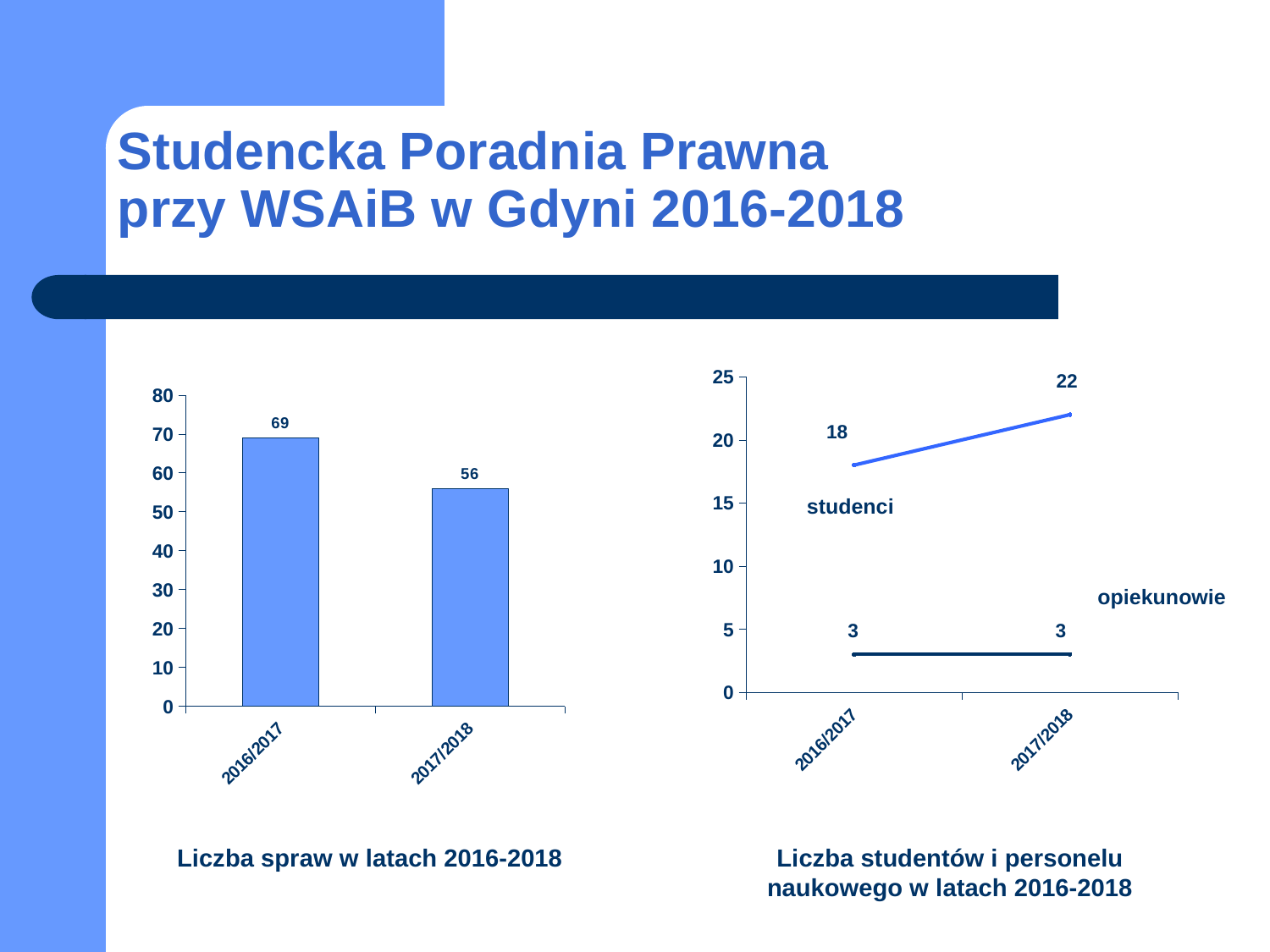
How many series are plotted in the right chart (Liczba studentów i personelu naukowego)? 2 In the left chart (Liczba spraw w latach 2016-2018), what is the value for 2016/2017? 69 In the left chart (Liczba spraw w latach 2016-2018), do the values rise or fall from 2016/2017 to 2017/2018? fall In the left chart (Liczba spraw w latach 2016-2018), what is the value for 2017/2018? 56 In the left chart (Liczba spraw w latach 2016-2018), which year has the higher number of cases? 2016/2017 In the right chart (Liczba studentów i personelu naukowego), does the studenci line rise or fall from 2016/2017 to 2017/2018? rise In the left chart (Liczba spraw w latach 2016-2018), what is the difference between the 2016/2017 and 2017/2018 values? 13 In the right chart (Liczba studentów i personelu naukowego), what is the value for studenci in 2017/2018? 22 What kind of chart is the left chart (Liczba spraw w latach 2016-2018)? bar chart What kind of chart is the right chart (Liczba studentów i personelu naukowego)? line chart In the right chart (Liczba studentów i personelu naukowego), what is the value for opiekunowie in 2016/2017? 3 In the right chart (Liczba studentów i personelu naukowego), by how much did the number of studenci increase from 2016/2017 to 2017/2018? 4